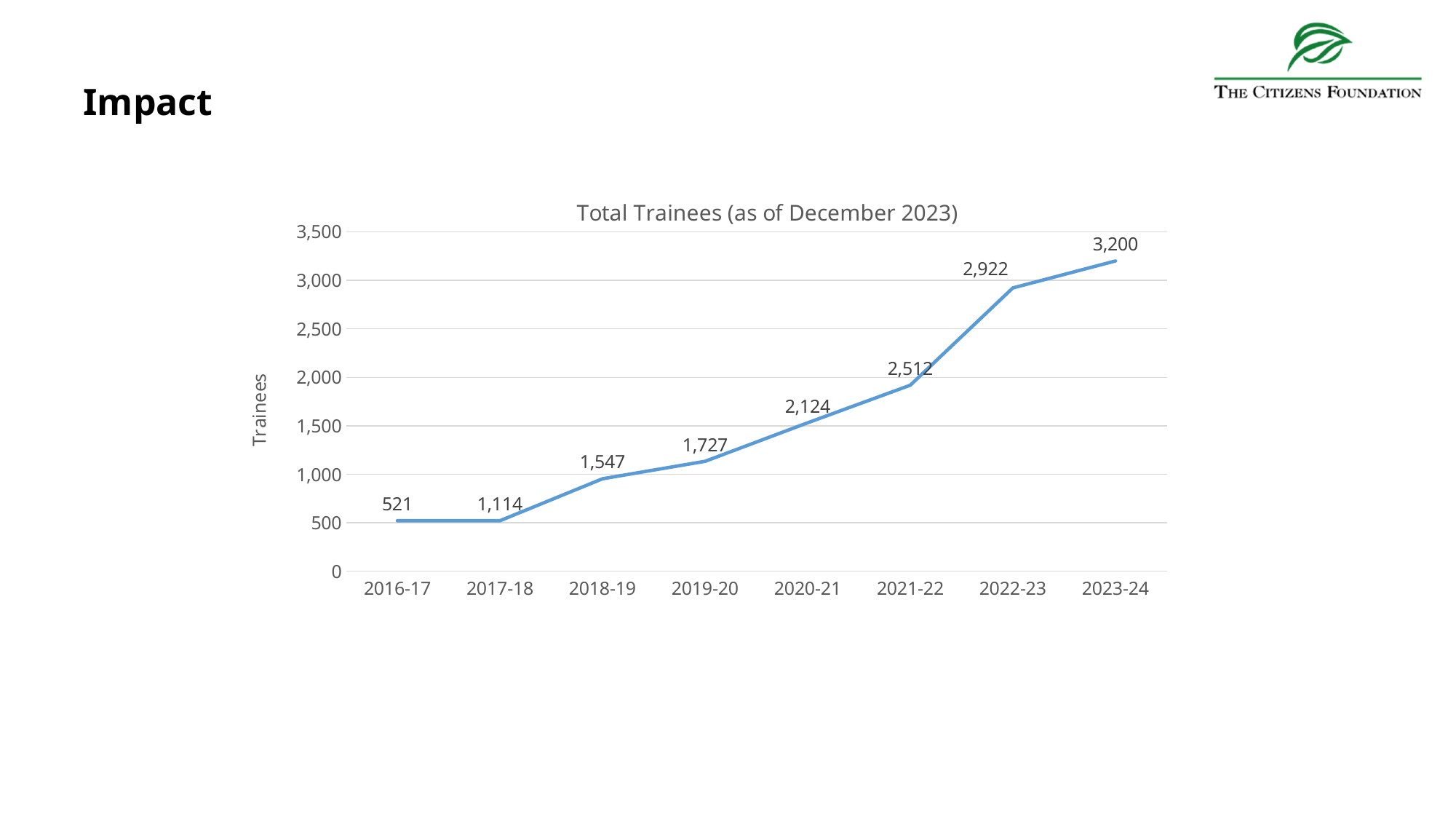
Do the values rise or fall from 2016-17 to 2023-24? rise Which is larger, the value for 2020-21 or the value for 2018-19? 2020-21 What is the difference between the values for 2023-24 and 2022-23? 278 What type of chart is shown on the slide? line chart How many years are plotted on the x axis? 8 What is the value for 2023-24? 3,200 Which year has the highest value? 2023-24 What is the value for 2016-17? 521 What is the title of the chart? Total Trainees (as of December 2023)